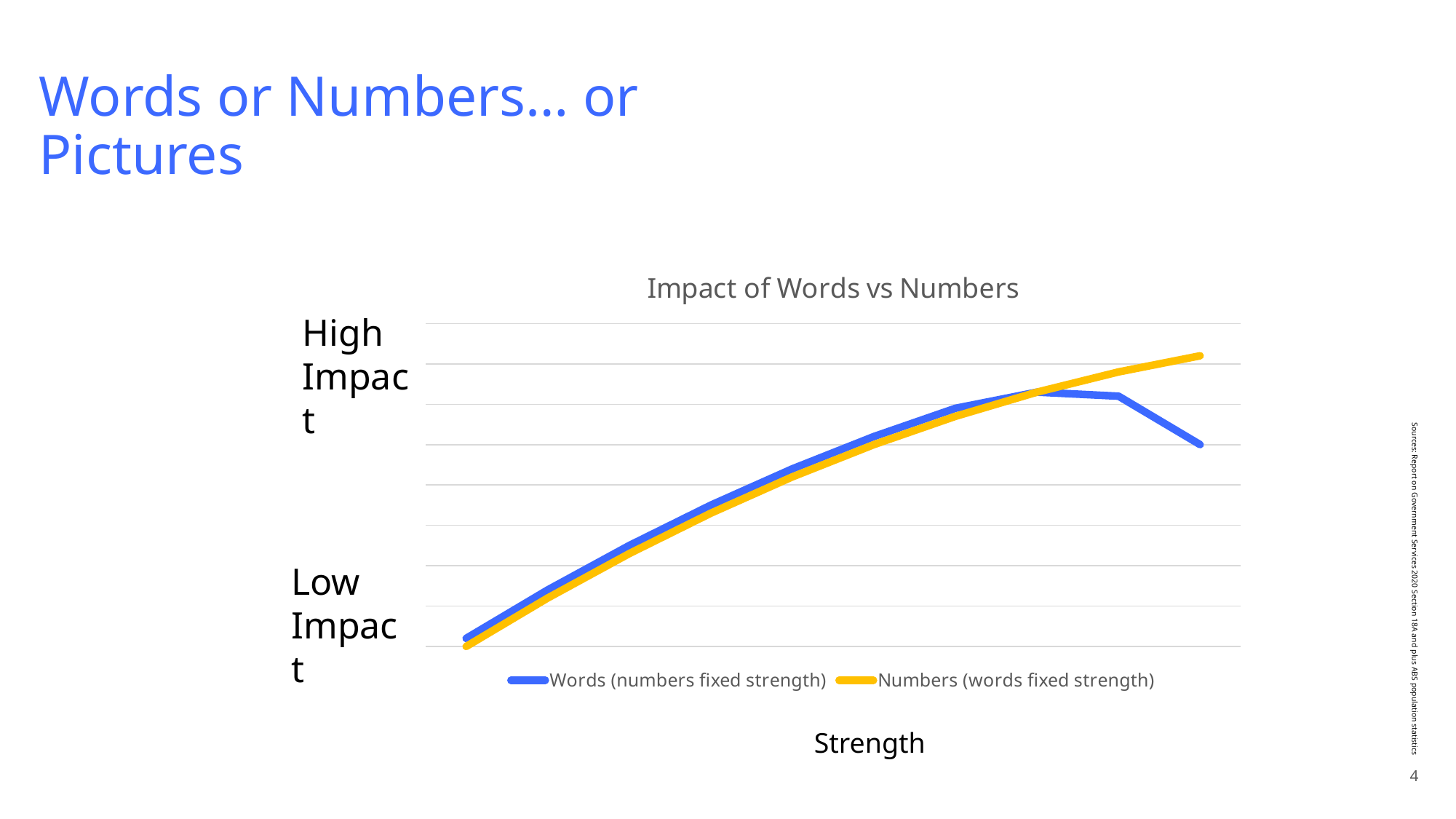
Which series is drawn in yellow in the chart? Numbers (words fixed strength) What kind of chart is shown on the slide? Line chart Does the Numbers (words fixed strength) line rise or fall as Strength increases along the x axis? Rises At the far right end of the x axis, which series has the higher impact: Words (numbers fixed strength) or Numbers (words fixed strength)? Numbers (words fixed strength) What is the title of the chart? Impact of Words vs Numbers Which series reaches the highest point on the chart? Numbers (words fixed strength) Does the Words (numbers fixed strength) line rise or fall over its last segment at the right end of the chart? Falls How many series does the legend of the chart list? 2